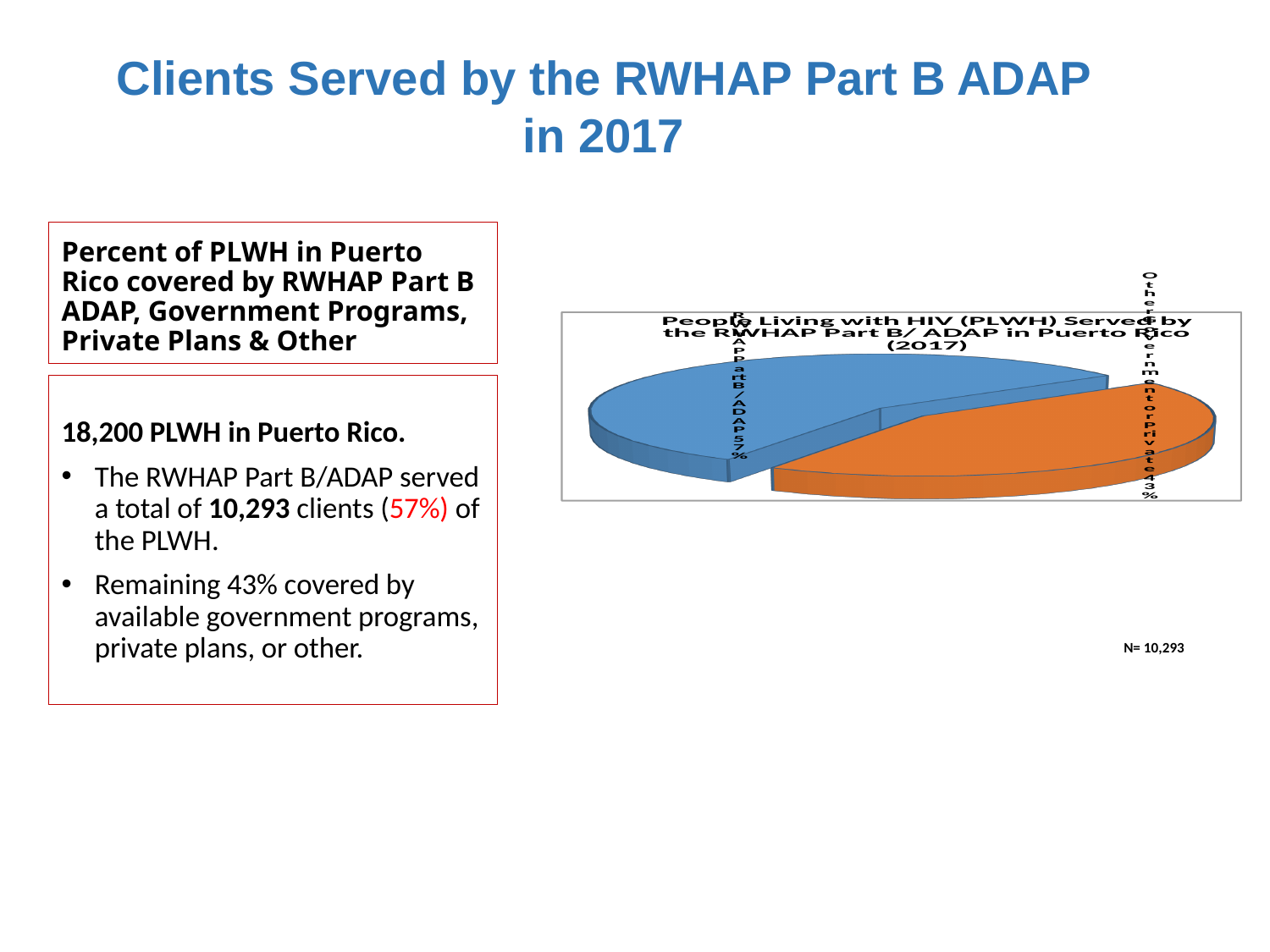
Which slice of the pie chart is the largest? RWHAP Part B/ADAP What is the title of the chart on the slide? People Living with HIV (PLWH) Served by the RWHAP Part B/ ADAP in Puerto Rico (2017) What is the difference in percentage points between the RWHAP Part B/ADAP slice and the Other Government or Private slice? 14 percentage points What share of the pie is labelled for RWHAP Part B/ADAP? 57% Which slice of the pie chart is the smallest? Other Government or Private Which is larger in the pie chart: the RWHAP Part B/ADAP slice or the Other Government or Private slice? RWHAP Part B/ADAP What kind of chart is shown on the slide? Pie chart What is the N value shown below the pie chart? N= 10,293 How many slices does the pie chart have? 2 What share of the pie is labelled for Other Government or Private? 43% What colour is the RWHAP Part B/ADAP slice in the pie chart? Blue